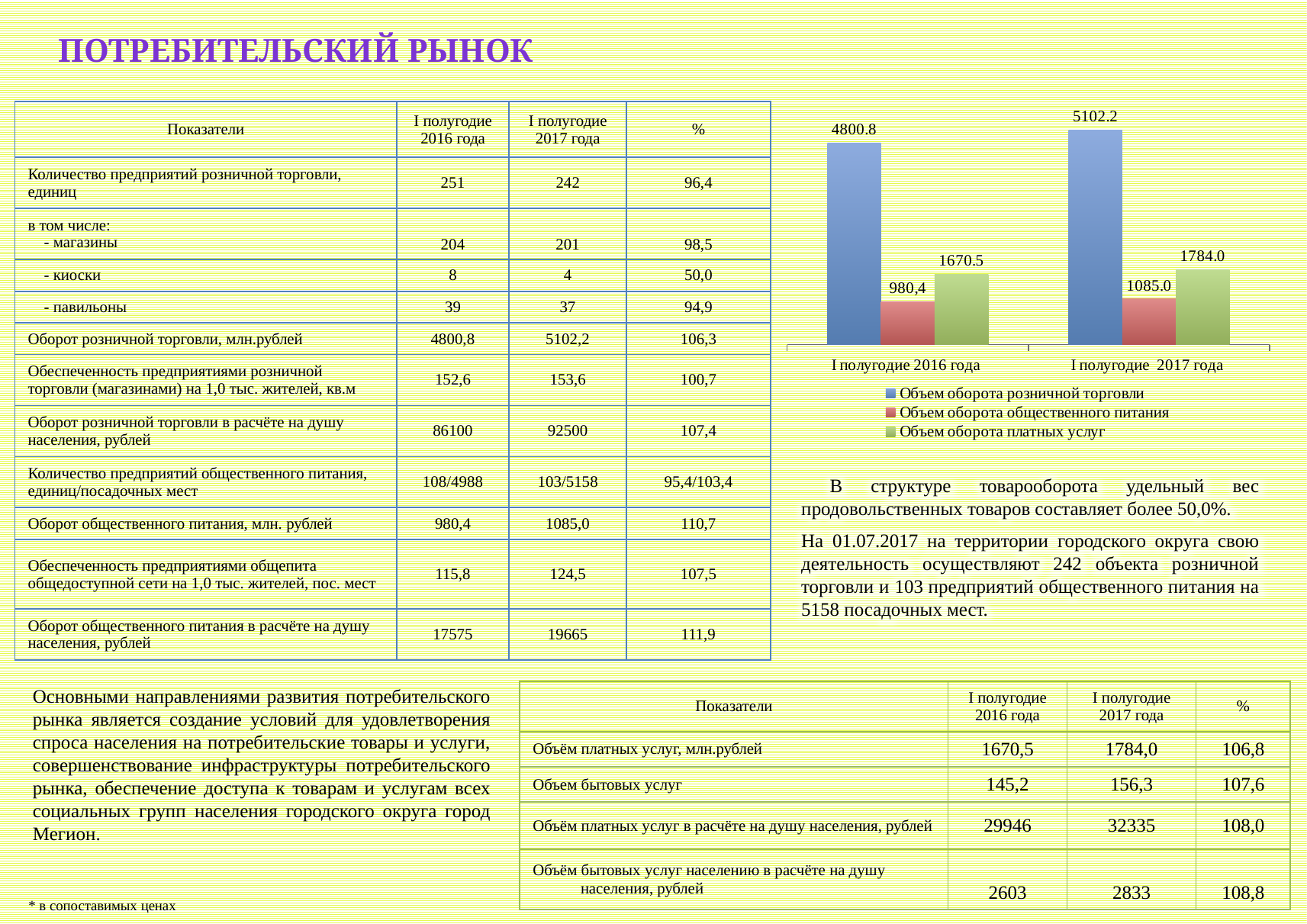
By how much did Объем оборота розничной торговли increase from I полугодие 2016 года to I полугодие 2017 года in the chart? 301.4 In the chart, is Объем оборота платных услуг larger in I полугодие 2016 года or I полугодие 2017 года? I полугодие 2017 года What is the value of Объем оборота платных услуг for I полугодие 2017 года in the chart? 1784.0 What type of chart is shown on the slide? Bar chart What is the value of Объем оборота общественного питания for I полугодие 2016 года in the chart? 980,4 What is the value of Объем оборота розничной торговли for I полугодие 2016 года in the chart? 4800.8 Which series has the highest value for I полугодие 2017 года in the chart? Объем оборота розничной торговли What is the value of Объем оборота розничной торговли for I полугодие 2017 года in the chart? 5102.2 Which series has the lowest value for I полугодие 2016 года in the chart? Объем оборота общественного питания What is the difference between Объем оборота платных услуг in I полугодие 2017 года and I полугодие 2016 года in the chart? 113.5 How many categories are shown on the x axis of the chart? 2 How many series does the chart legend list? 3